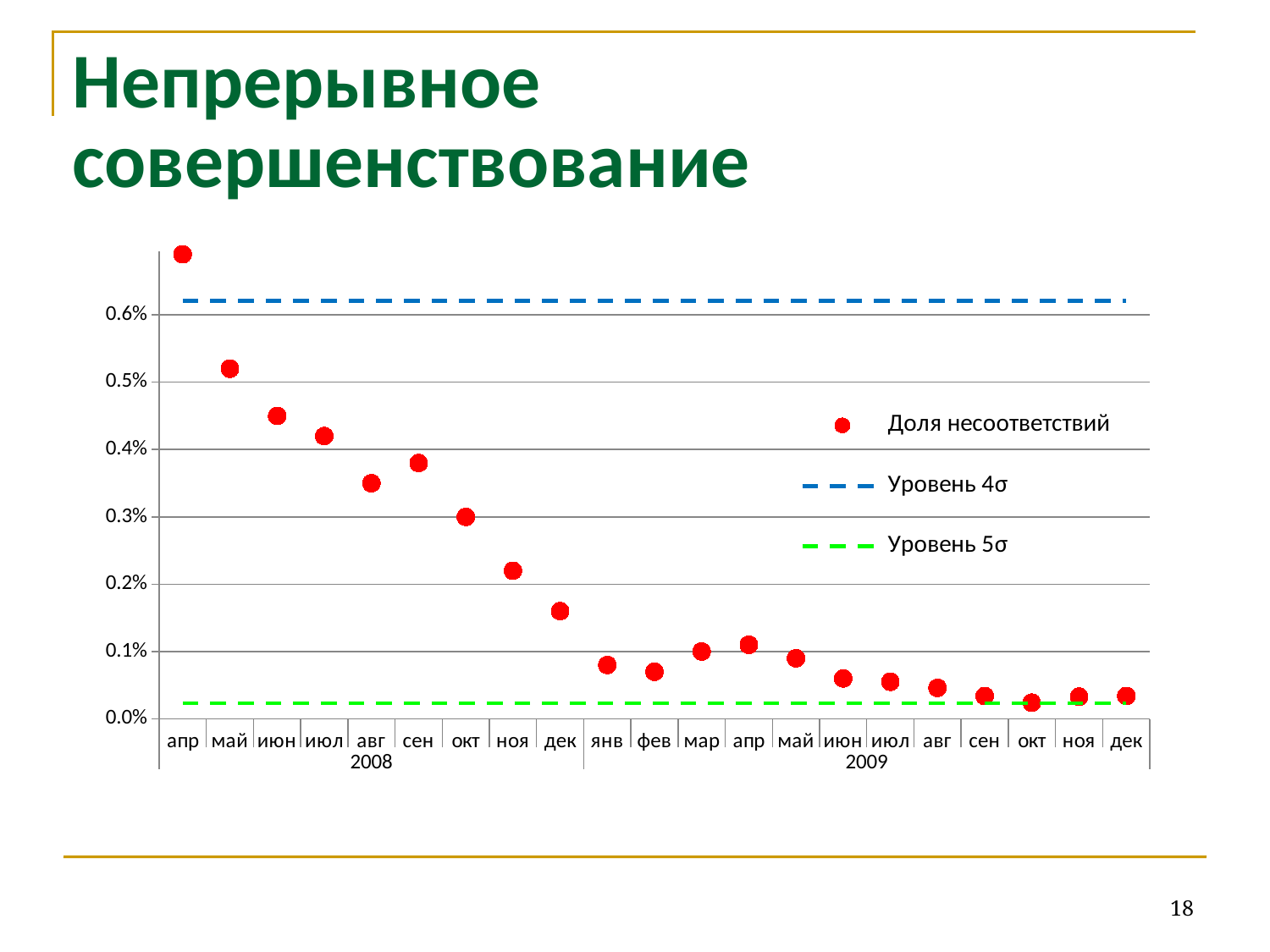
How many data points are plotted for the series Доля несоответствий? 21 How many series does the legend list? 3 Which month has the highest value for Доля несоответствий? апр 2008 What kind of chart is shown on the slide? line chart Is the value for Доля несоответствий in май 2008 greater or less than 0.5%? greater What is the name of the series shown with a green dashed line? Уровень 5σ Is the value for Доля несоответствий in дек 2008 greater or less than 0.2%? less Which is larger, the value for Доля несоответствий in май 2008 or in дек 2009? май 2008 Do the values for Доля несоответствий rise or fall from апр 2008 to дек 2009? fall Is the value for Доля несоответствий in апр 2008 greater or less than 0.6%? greater